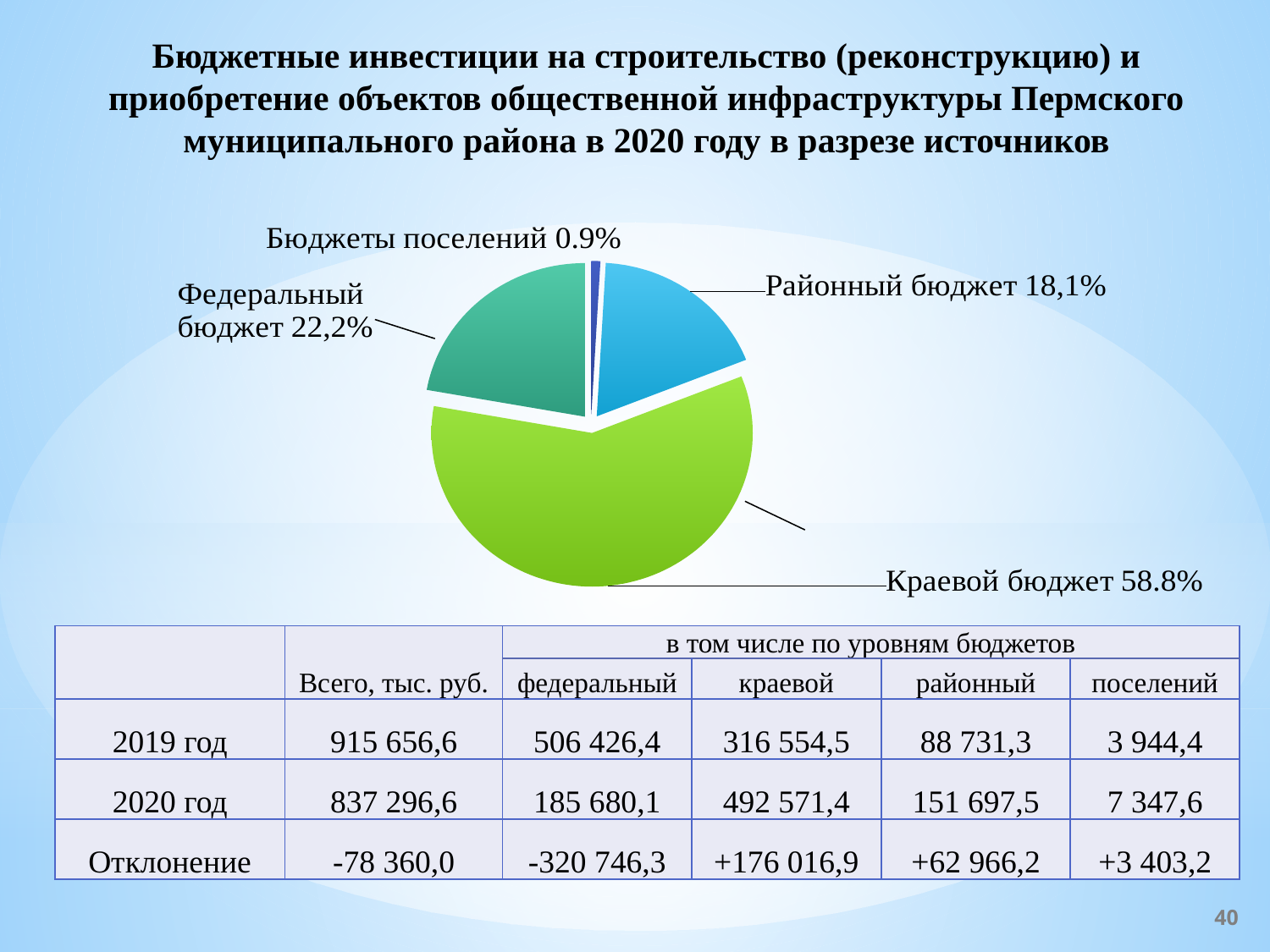
Which source has the smallest slice of the pie? Бюджеты поселений What share of the pie does Районный бюджет have? 18,1% What share of the pie does Бюджеты поселений have? 0.9% What share of the pie does Краевой бюджет have? 58.8% By how many percentage points does the share of Федеральный бюджет exceed the share of Районный бюджет? 4,1 What colour is the slice for Краевой бюджет? green How many slices does the pie chart have? 4 Which is larger, the share of Федеральный бюджет or the share of Районный бюджет? Федеральный бюджет Which source has the largest slice of the pie? Краевой бюджет By how many percentage points does the share of Краевой бюджет exceed the share of Бюджеты поселений? 57.9 What kind of chart is shown on the slide? pie chart